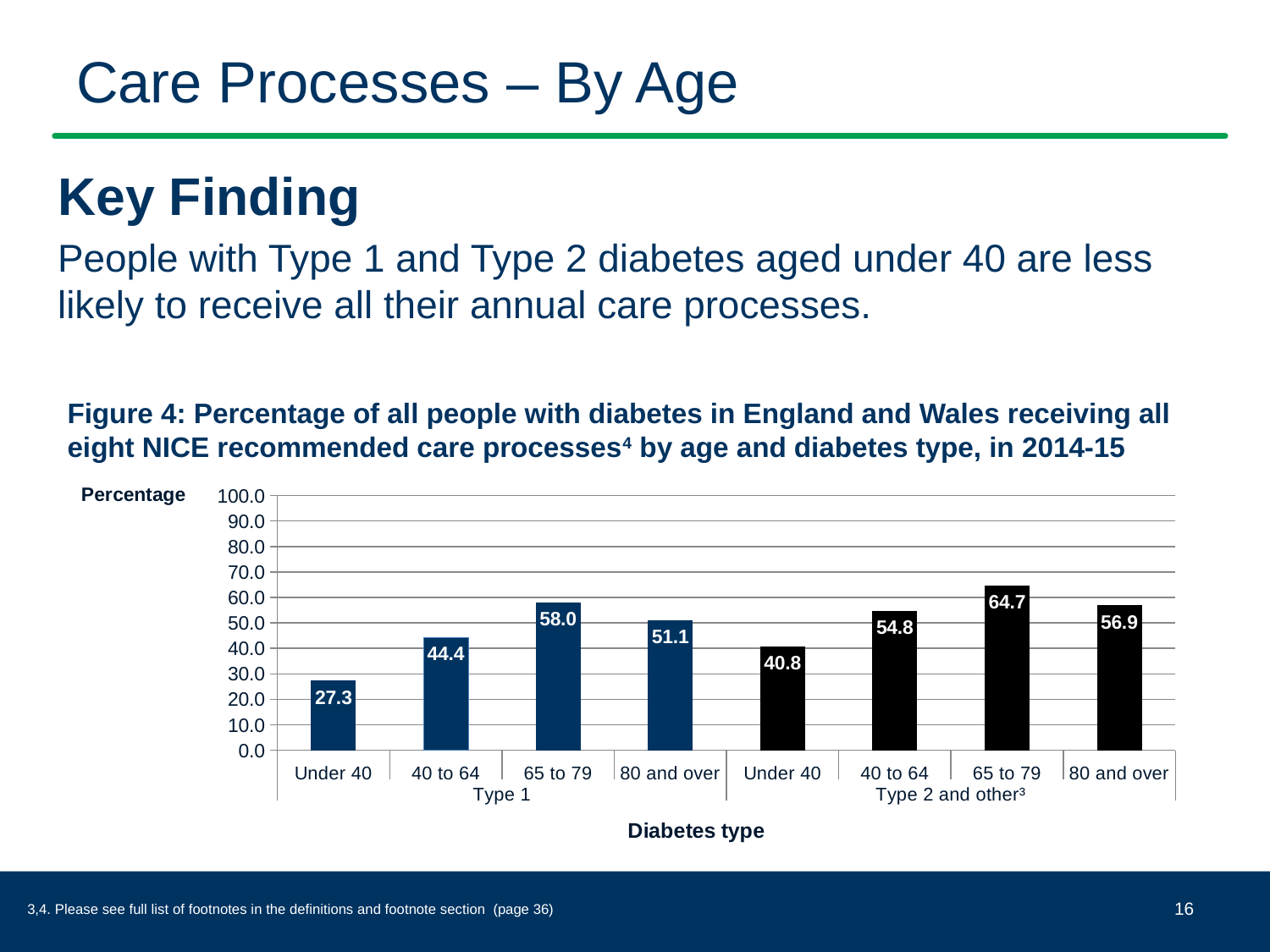
What is the value for 80 and over in the Type 1 group? 51.1 Which bar has the highest value on the chart? 65 to 79 (Type 2 and other) Is the value for 80 and over in the Type 2 and other group greater or less than 50.0? greater Which is larger: the 40 to 64 value for Type 1 or for Type 2 and other? Type 2 and other What is the difference between the 65 to 79 and Under 40 values in the Type 1 group? 30.7 Which age group has the lowest value in the Type 1 group? Under 40 What is the value for 65 to 79 in the Type 2 and other group? 64.7 What is the value for Under 40 in the Type 1 group? 27.3 How many bars are plotted on the chart? 8 What is the label of the horizontal axis? Diabetes type What is the difference between the Under 40 values for Type 2 and other and Type 1? 13.5 What kind of chart is shown? Bar chart